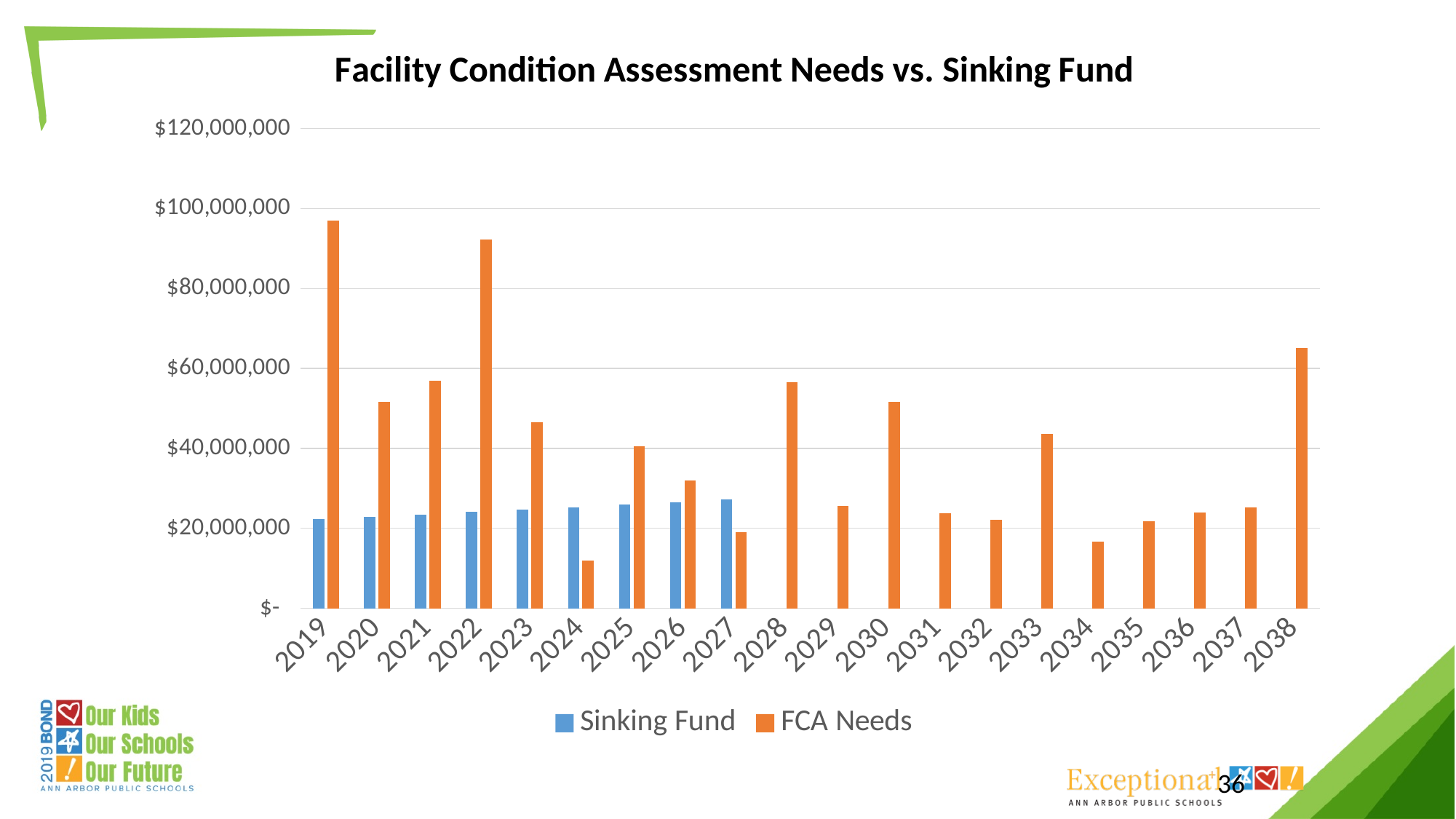
Is the FCA Needs value for 2034 greater or less than $20,000,000? less How many series does the legend list? 2 Is the FCA Needs value for 2038 greater or less than $60,000,000? greater Which year has the highest Sinking Fund value? 2027 How many years are shown on the x axis? 20 Which year has the highest FCA Needs value? 2019 Which series is shown in orange? FCA Needs Is the FCA Needs value for 2022 greater or less than $80,000,000? greater Do the Sinking Fund values rise or fall from 2019 to 2027? rise In 2024, which is larger: the Sinking Fund or the FCA Needs? Sinking Fund What kind of chart is shown on the slide? bar chart Which year has the lowest FCA Needs value? 2024